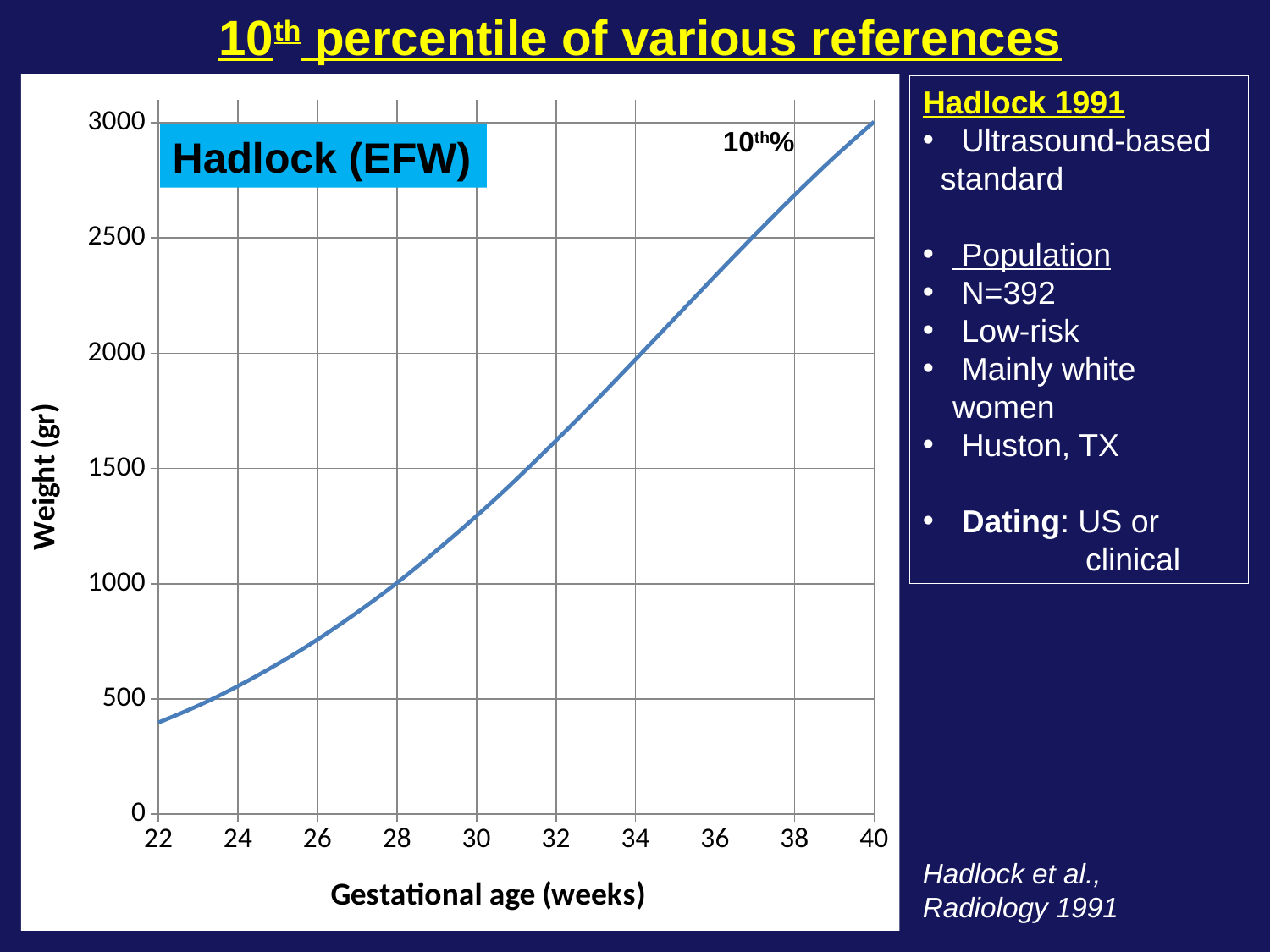
Does the weight rise or fall as gestational age increases from 22 to 40 weeks? rises Is the weight at 38 weeks greater or less than 2500? greater Which is larger, the weight at 32 weeks or the weight at 28 weeks? 32 weeks Is the weight at 26 weeks greater or less than 1000? less At which gestational age is the plotted weight highest? 40 weeks Is the weight at 22 weeks greater or less than 500? less At which gestational age is the plotted weight lowest? 22 weeks What kind of chart is shown on the slide? line chart What is the label on the y axis of the chart? Weight (gr) What title is shown in the blue box inside the chart? Hadlock (EFW)